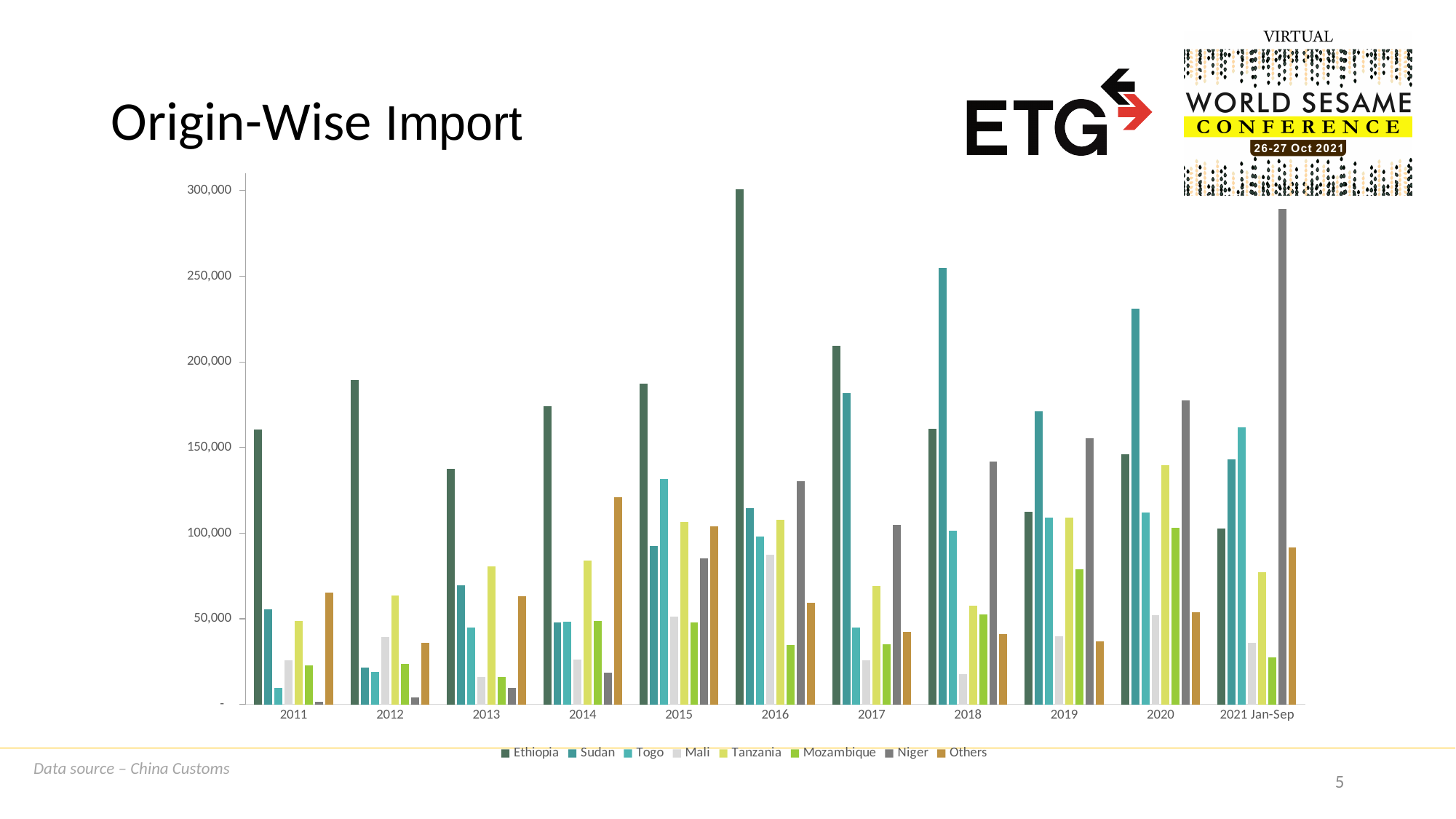
In which year is the Ethiopia bar the highest? 2016 How many series does the legend list? 8 Is the value for Niger in 2021 Jan-Sep greater or less than 250,000? greater Which is larger in 2020, the Sudan bar or the Togo bar? Sudan How many year categories are shown along the x axis? 11 Does the Niger series rise or fall from 2017 through 2021 Jan-Sep? Rises Which origin has the highest bar in 2021 Jan-Sep? Niger What kind of chart is shown on the slide? Bar chart What is the title of the chart on the slide? Origin-Wise Import Is the value for Ethiopia in 2016 greater or less than 250,000? greater Which origin has the highest bar in 2018? Sudan Is the value for Ethiopia in 2019 greater or less than 150,000? less